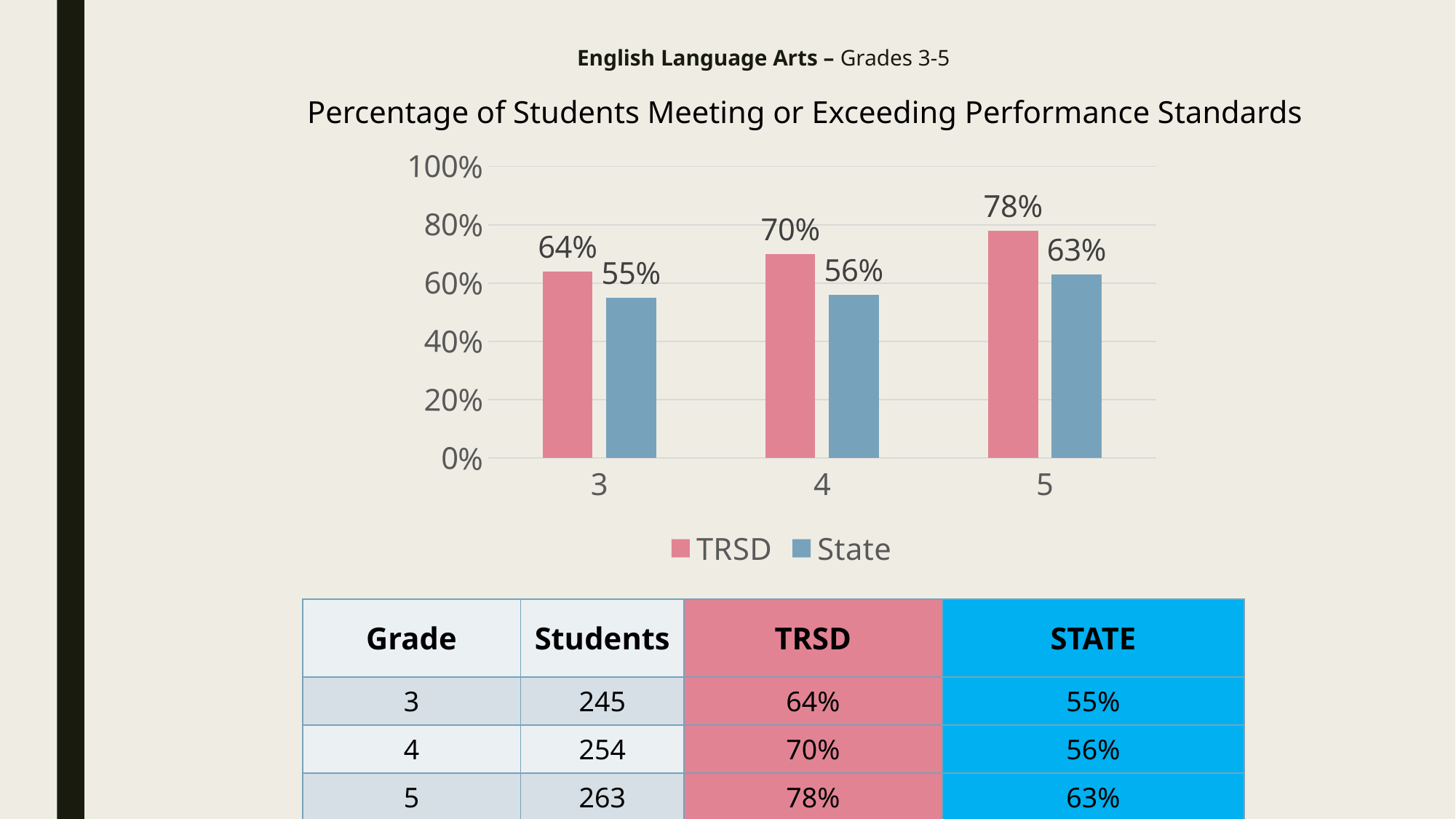
What is the State value for grade 4? 56% What is the State value for grade 5? 63% What is the TRSD value for grade 3? 64% What is the difference between the TRSD and State values for grade 5? 15% What is the difference between the TRSD values for grade 4 and grade 3? 6% Which grade has the lowest State value? 3 How many grades are shown on the x axis of the chart? 3 Which grade has the highest TRSD value? 5 What kind of chart is shown on the slide? Bar chart Do the TRSD values rise or fall from grade 3 to grade 5? Rise How many series does the legend list? 2 Which is larger for grade 4, the TRSD value or the State value? TRSD